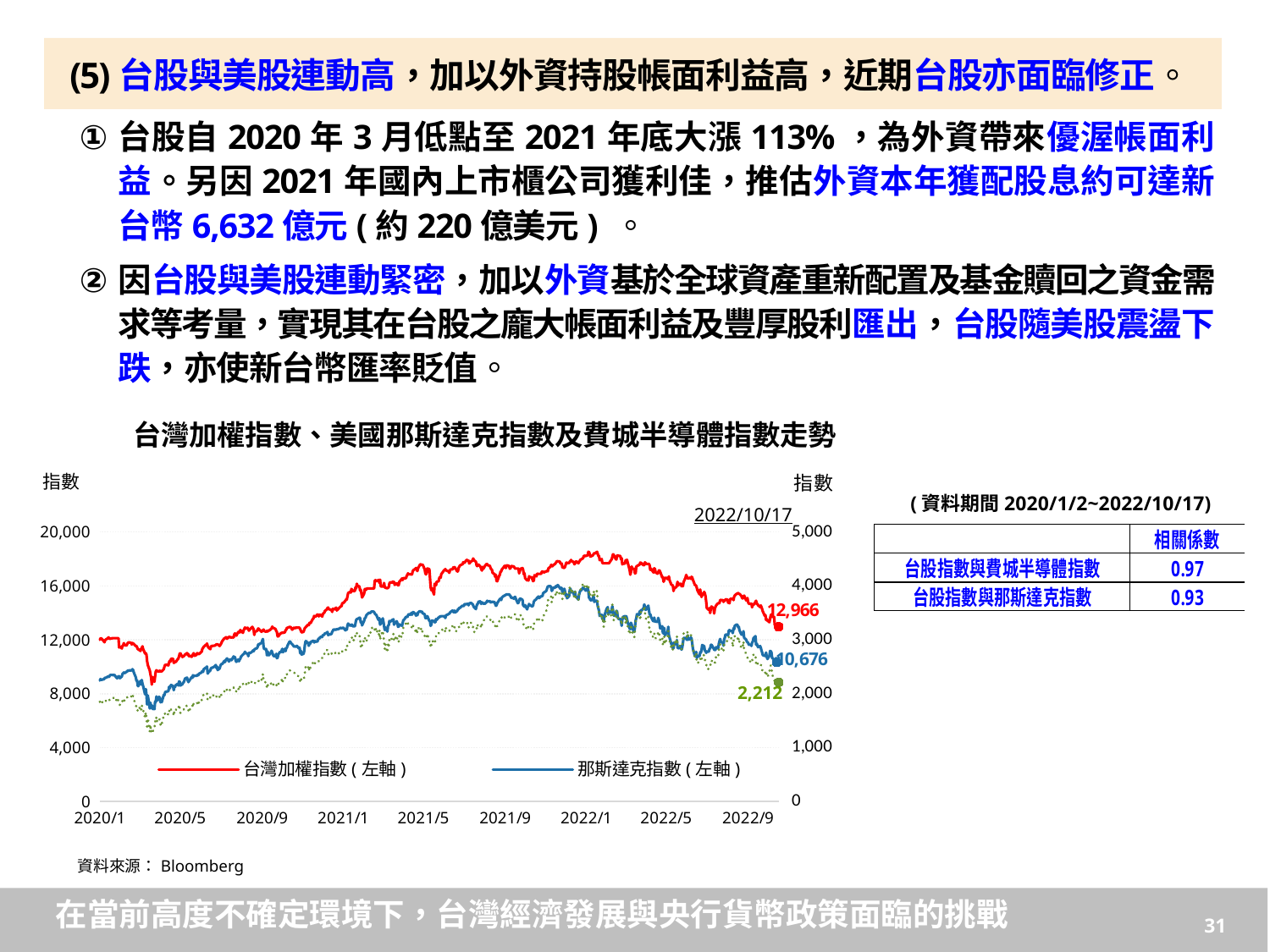
What is the difference between the labelled end values of 台灣加權指數 (12,966) and 那斯達克指數 (10,676)? 2,290 What value is labelled for 台灣加權指數 at the end of the series on 2022/10/17? 12,966 Is the value for 台灣加權指數 at 2020/1 greater or less than 8,000? greater Is the value for 那斯達克指數 at 2020/1 greater or less than 12,000? less At the end of the chart, which is larger: 台灣加權指數 or 那斯達克指數? 台灣加權指數 What kind of chart is shown on the slide? line chart What is the highest tick shown on the right-hand axis of the chart? 5,000 Does 台灣加權指數 rise or fall between 2022/1 and 2022/9? fall What value is labelled at the end of the green dotted line on 2022/10/17? 2,212 How many series does the chart legend list? 2 What value is labelled for 那斯達克指數 at the end of the series on 2022/10/17? 10,676 What is the data source given below the chart? Bloomberg